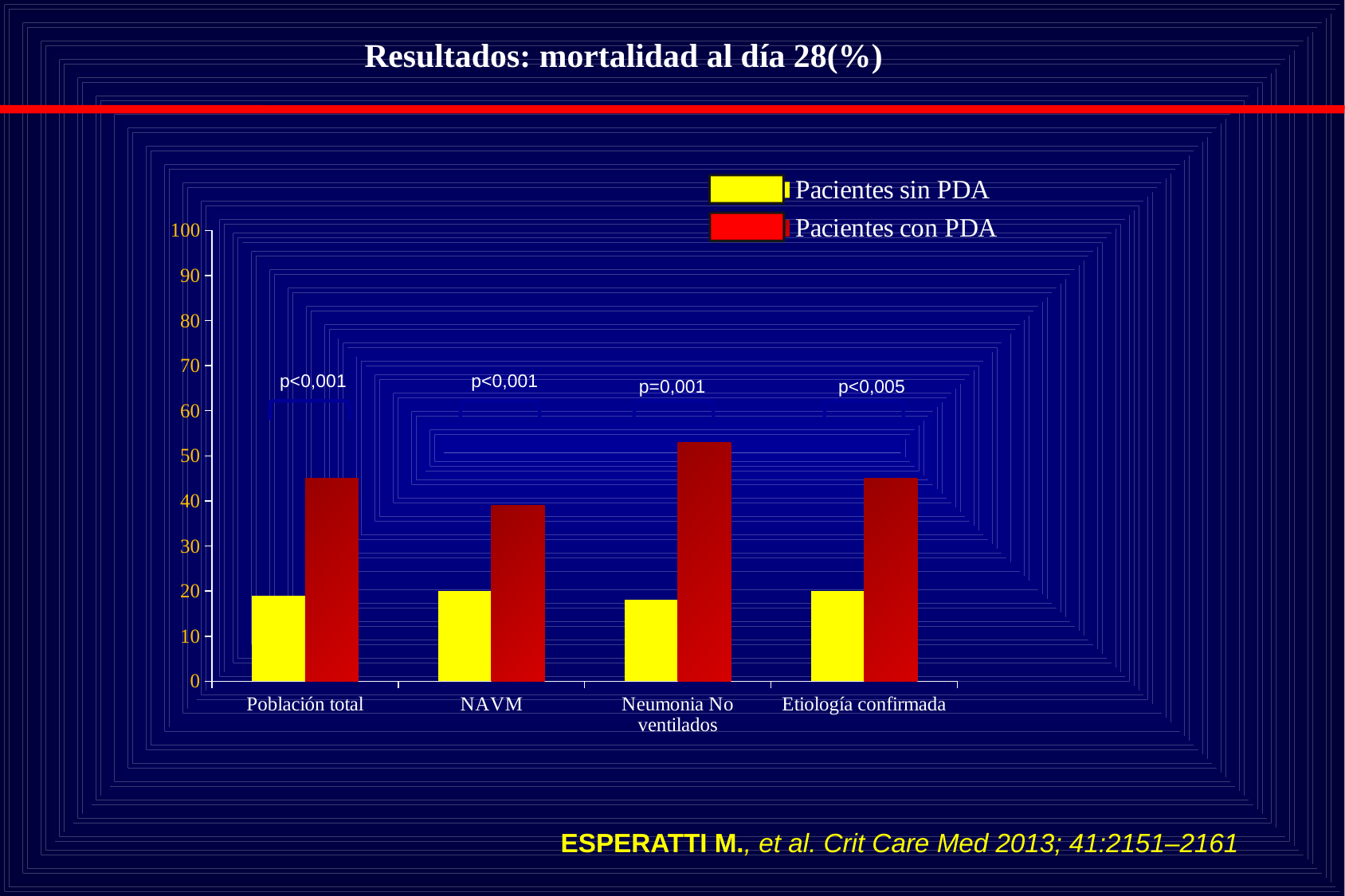
What kind of chart is shown on the slide? bar chart How many categories are shown on the x axis? 4 Which category has the highest value for Pacientes con PDA? Neumonia No ventilados Is the value for Pacientes con PDA in Neumonia No ventilados greater or less than 50? greater Which category has the lowest value for Pacientes con PDA? NAVM Is the value for Pacientes sin PDA in Población total greater or less than 30? less For Población total, which is larger: Pacientes sin PDA or Pacientes con PDA? Pacientes con PDA What is the title of the chart? Resultados: mortalidad al día 28(%) Is the value for Pacientes con PDA in NAVM greater or less than 30? greater How many series does the legend list? 2 Which is larger: Pacientes con PDA for Neumonia No ventilados or Pacientes con PDA for NAVM? Neumonia No ventilados